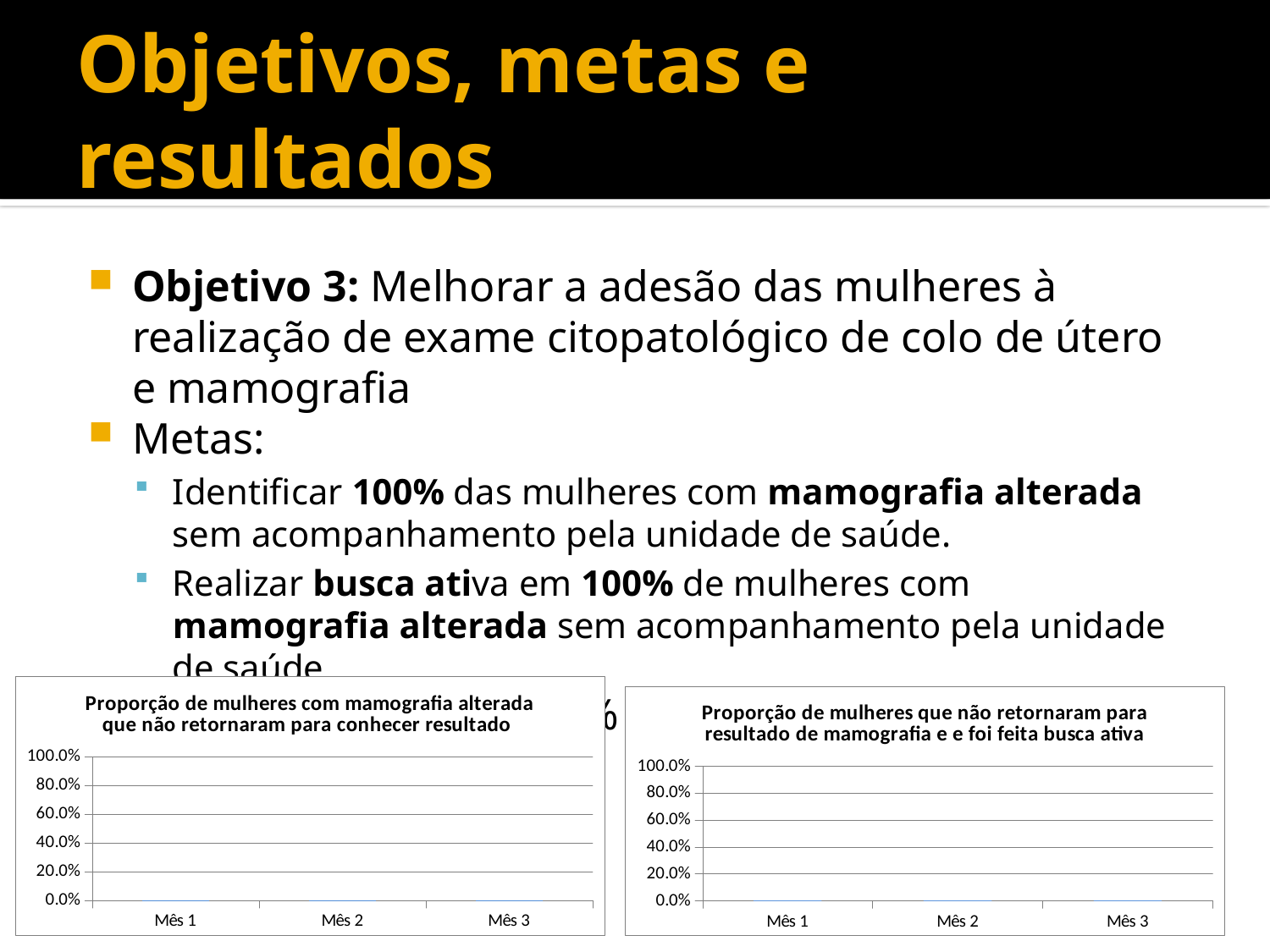
In the right chart, is the value for Mês 2 greater or less than 20.0%? less In the left chart, is the value for Mês 3 greater or less than 40.0%? less What kind of chart is the left chart, titled 'Proporção de mulheres com mamografia alterada que não retornaram para conhecer resultado'? bar chart In the right chart, is the value for Mês 3 greater or less than 60.0%? less What kind of chart is the right chart, titled 'Proporção de mulheres que não retornaram para resultado de mamografia e e foi feita busca ativa'? bar chart What is the highest value shown on the y axis of the right chart? 100.0% What is the label of the first category on the x axis of the left chart? Mês 1 What is the label of the last category on the x axis of the right chart? Mês 3 What is the title of the left chart? Proporção de mulheres com mamografia alterada que não retornaram para conhecer resultado In the left chart, how many categories are shown on the x axis? 3 In the right chart, how many categories are shown on the x axis? 3